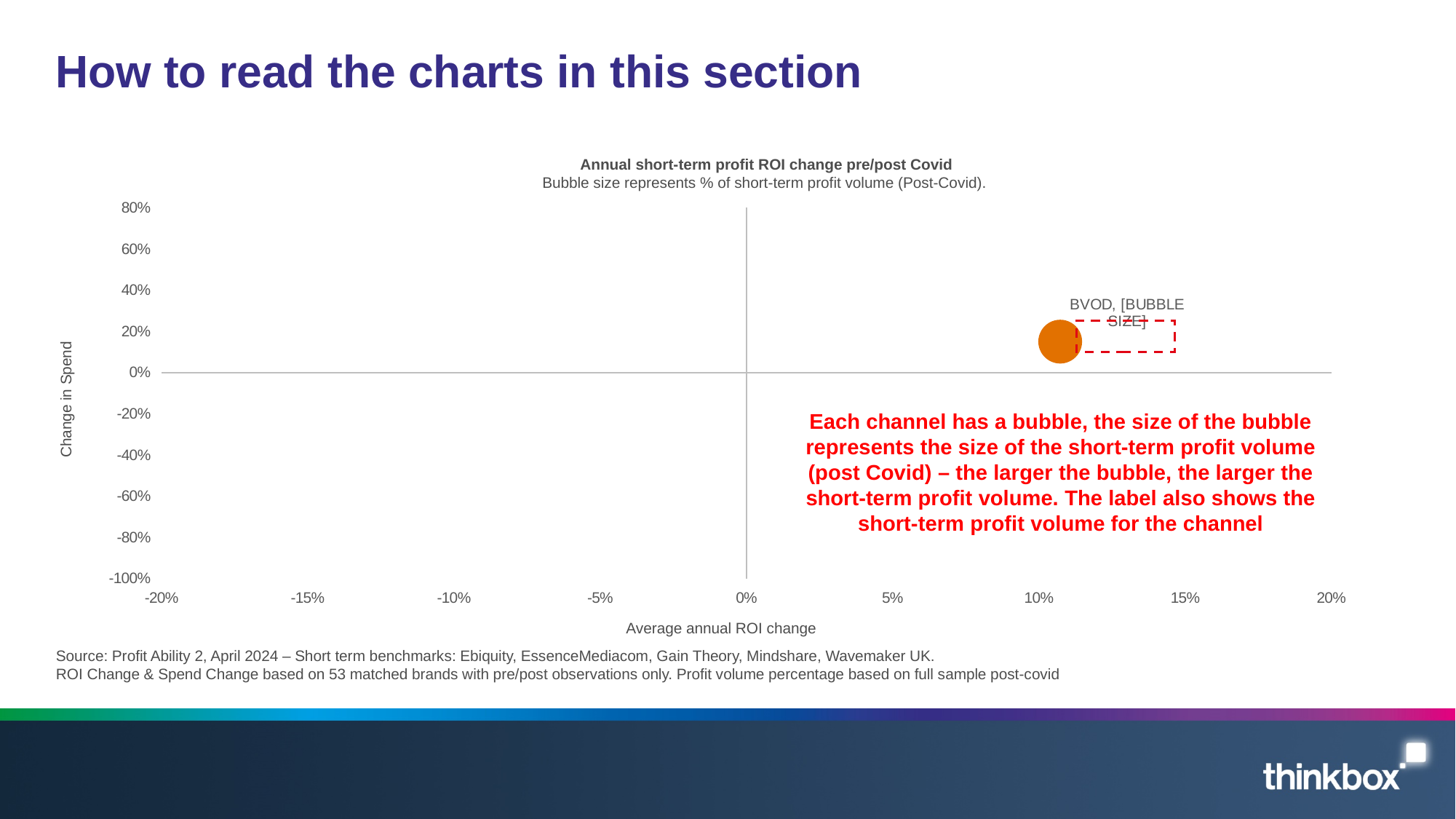
Is the average annual ROI change for BVOD greater or less than 5%? greater What kind of chart is shown on the slide? Bubble chart How many bubbles are plotted on the chart? 1 Is the change in spend for BVOD greater or less than 40%? less Which channel is labelled on the plotted bubble? BVOD Is the average annual ROI change for BVOD greater or less than 0%? greater What is the title of the chart? Annual short-term profit ROI change pre/post Covid What is the label of the vertical axis of the chart? Change in Spend